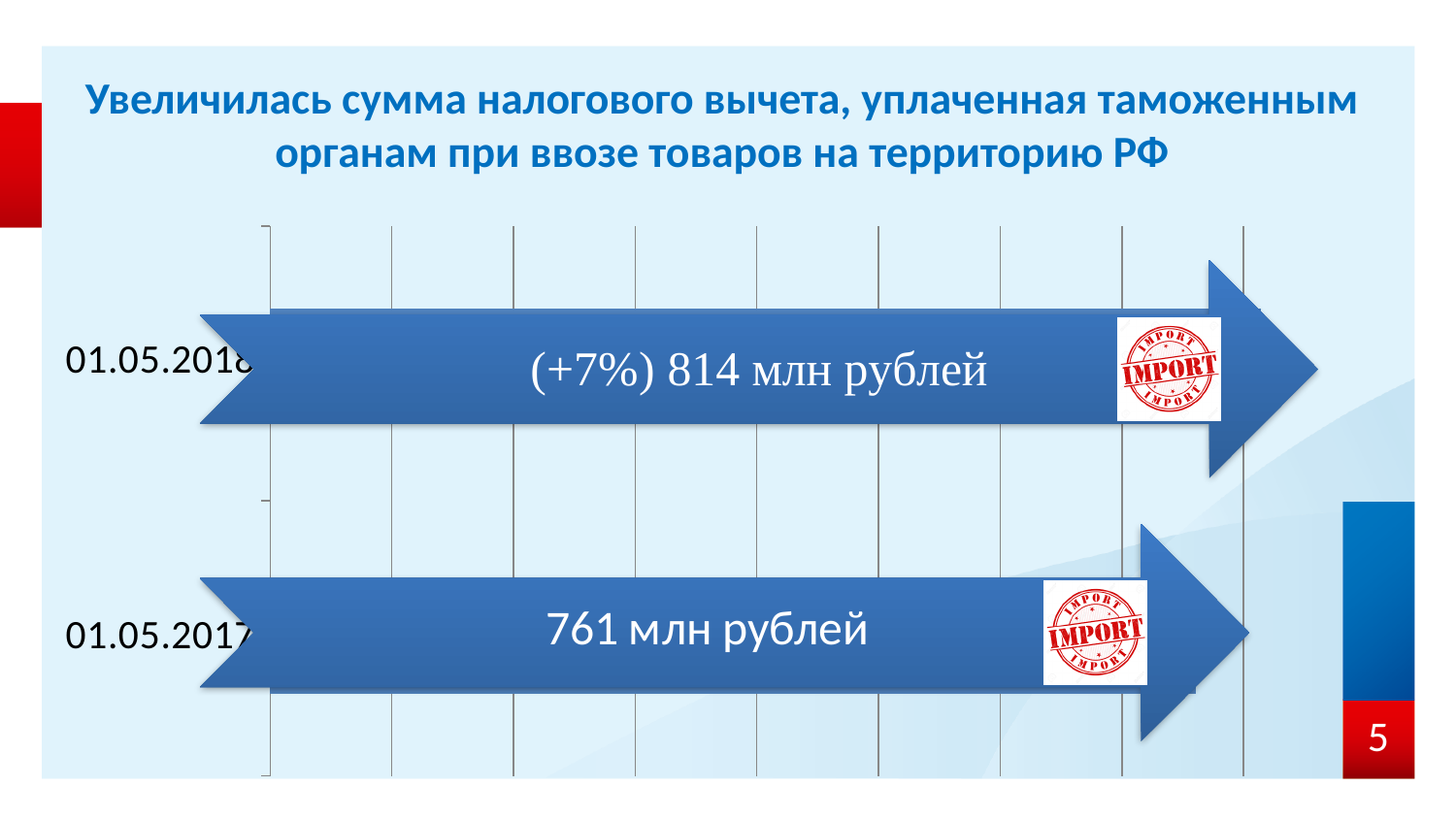
Which date has the higher value? 01.05.2018 What kind of chart is shown on the slide? bar chart What is the value shown for 01.05.2017? 761 млн рублей Is the value for 01.05.2017 larger or smaller than the value for 01.05.2018? smaller What is the title of the slide containing the chart? Увеличилась сумма налогового вычета, уплаченная таможенным органам при ввозе товаров на территорию РФ What word appears on the red stamp image placed on each bar? IMPORT What percentage change is printed on the bar for 01.05.2018? +7% How many categories (dates) are shown in the chart? 2 What is the value shown for 01.05.2018? 814 млн рублей Did the value rise or fall from 01.05.2017 to 01.05.2018? rise What is the difference between the values for 01.05.2018 and 01.05.2017? 53 млн рублей Which date has the lower value? 01.05.2017